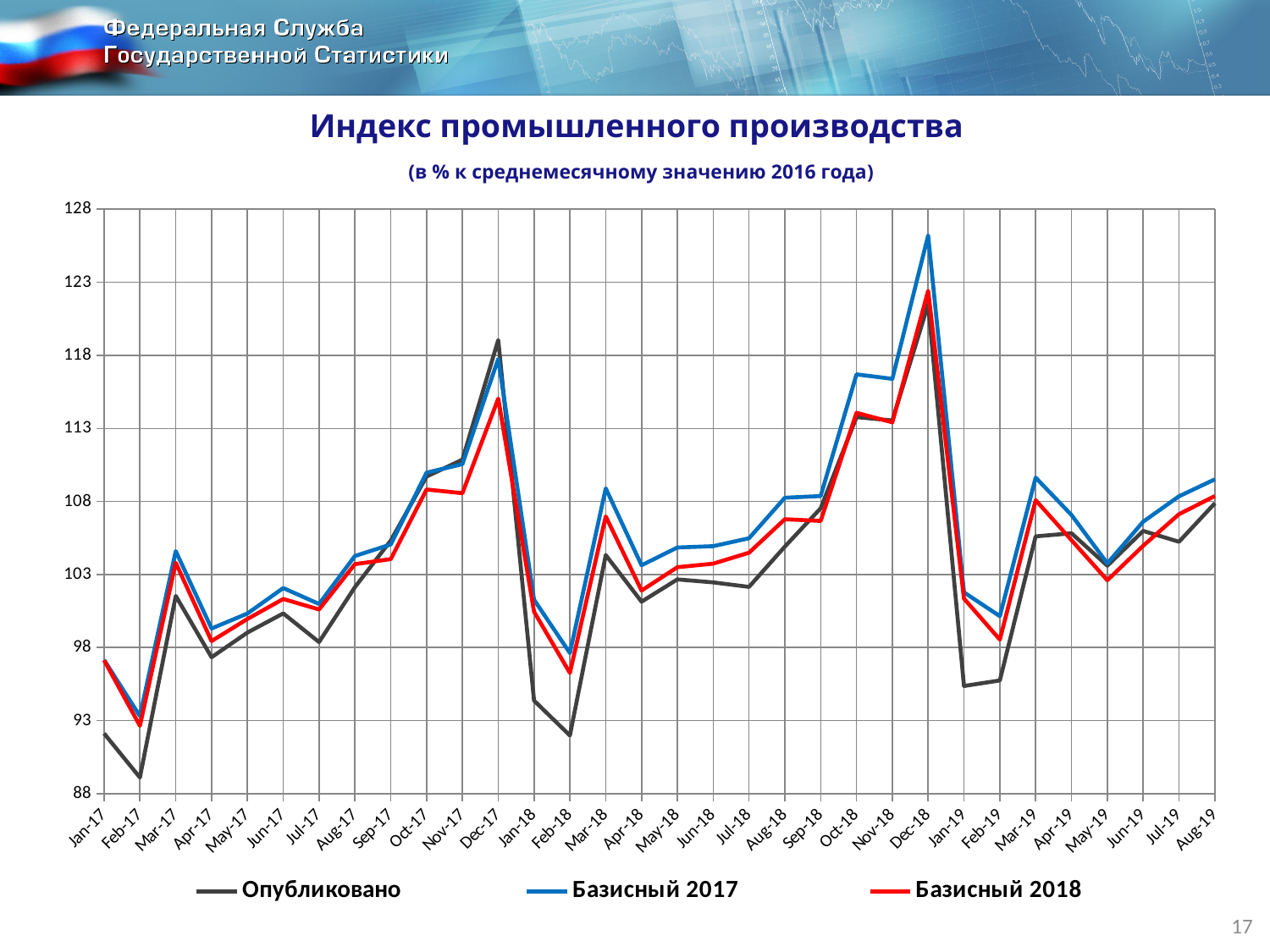
Does the Базисный 2017 series rise or fall from Sep-18 to Dec-18? rise Is the value of Базисный 2017 for Dec-18 greater or less than 123? greater In which month does the Опубликовано series reach its lowest value? Feb-17 In Jan-18, which series has the higher value: Опубликовано or Базисный 2017? Базисный 2017 How many series does the legend list? 3 What kind of chart is shown on the slide? line chart How many monthly points are plotted along the x axis, from Jan-17 to Aug-19? 32 Which series is drawn in red? Базисный 2018 Is the value of Базисный 2018 for Feb-18 greater or less than 98? less Is the value of Опубликовано for Jan-19 greater or less than 98? less In which month does the Базисный 2017 series reach its highest value? Dec-18